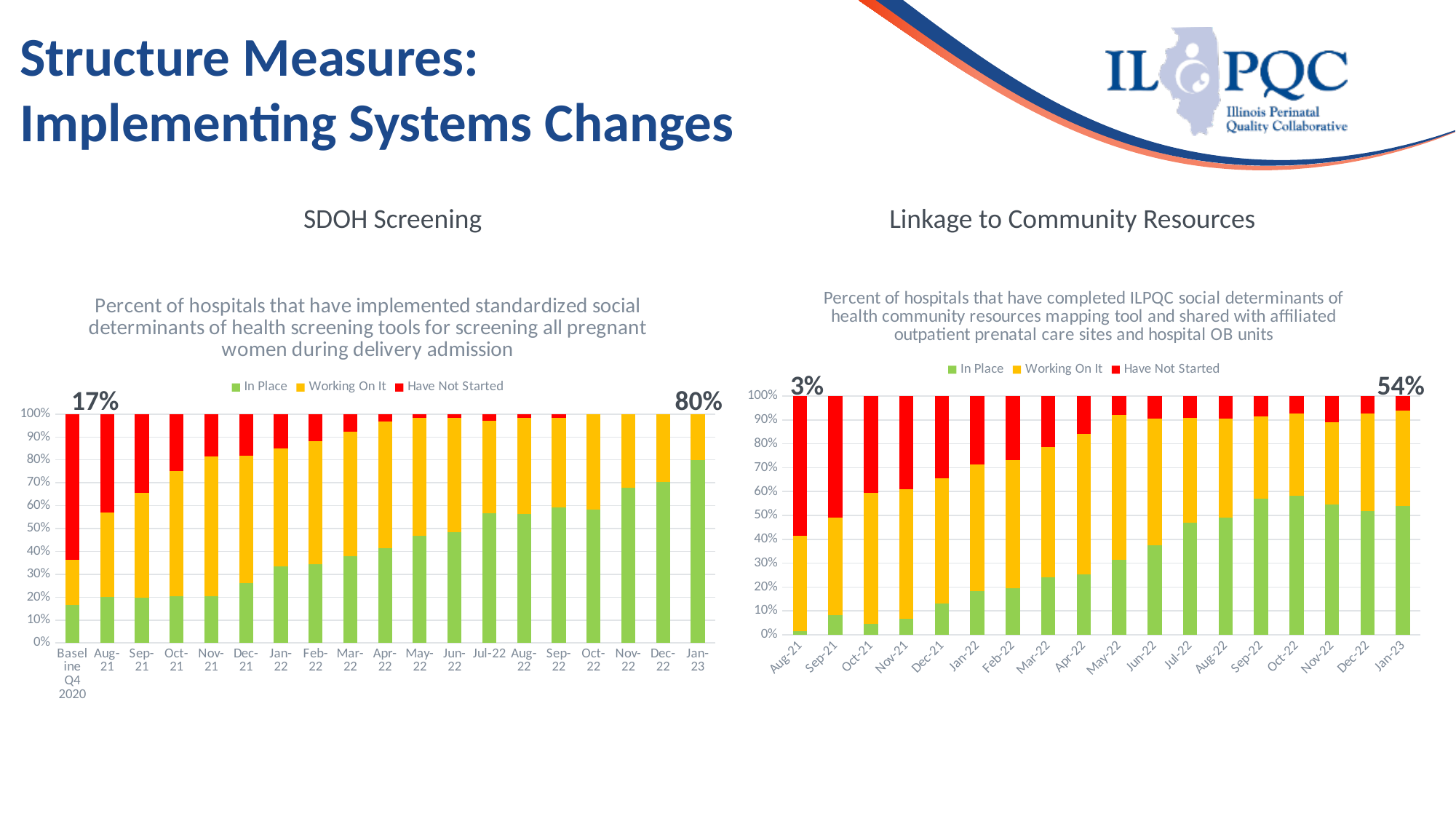
What type of chart is the SDOH Screening chart? Stacked bar chart In the SDOH Screening chart, what percent of hospitals had the screening tool In Place at Baseline Q4 2020? 17% In the Linkage to Community Resources chart, what percent of hospitals were In Place in Jan-23? 54% How many time periods are shown on the x axis of the SDOH Screening chart? 19 How many months are shown on the x axis of the Linkage to Community Resources chart? 18 How many series does the legend of the Linkage to Community Resources chart list? 3 In the SDOH Screening chart, is the In Place value for Nov-22 greater or less than 60%? greater In the Linkage to Community Resources chart, does the In Place share generally rise or fall from Aug-21 to Jan-23? Rise In the Linkage to Community Resources chart, what percent of hospitals were In Place in Aug-21? 3% In the Linkage to Community Resources chart, by how many percentage points did the In Place share increase from Aug-21 to Jan-23? 51 percentage points In the SDOH Screening chart, what percent of hospitals had the screening tool In Place in Jan-23? 80% In the SDOH Screening chart, by how many percentage points did the In Place share increase from Baseline Q4 2020 to Jan-23? 63 percentage points